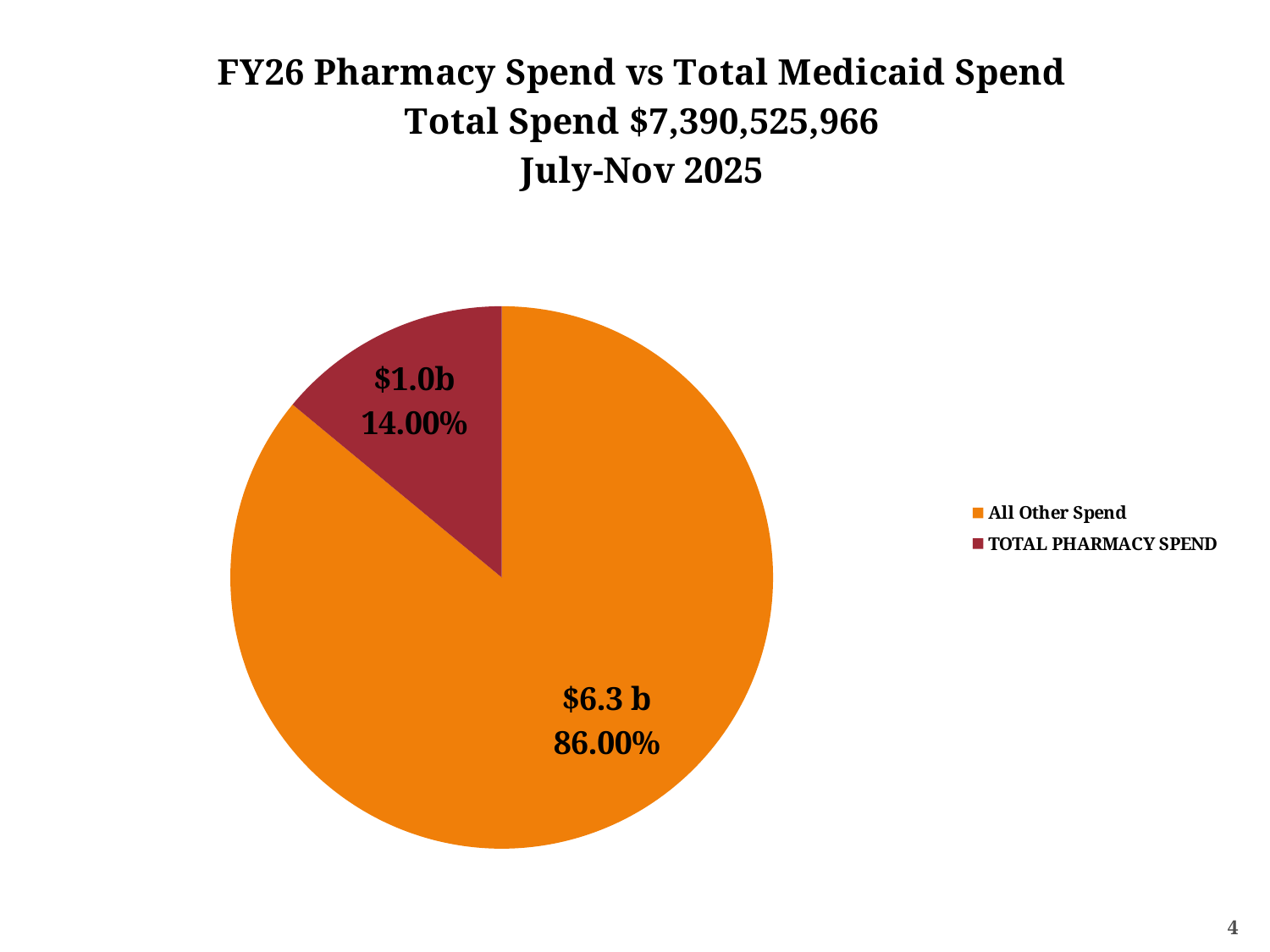
How many slices does the pie chart have? 2 What total spend is stated in the chart title? $7,390,525,966 What is the value labelled on the TOTAL PHARMACY SPEND slice? $1.0b What is the difference in percentage points between the All Other Spend share and the TOTAL PHARMACY SPEND share? 72.00% What is the value labelled on the All Other Spend slice? $6.3 b Which is larger, All Other Spend or TOTAL PHARMACY SPEND? All Other Spend What kind of chart is shown on the slide? pie chart What share of the pie does TOTAL PHARMACY SPEND represent? 14.00% What colour is the TOTAL PHARMACY SPEND slice? dark red Which slice is the largest? All Other Spend Which slice is the smallest? TOTAL PHARMACY SPEND What share of the pie does All Other Spend represent? 86.00%